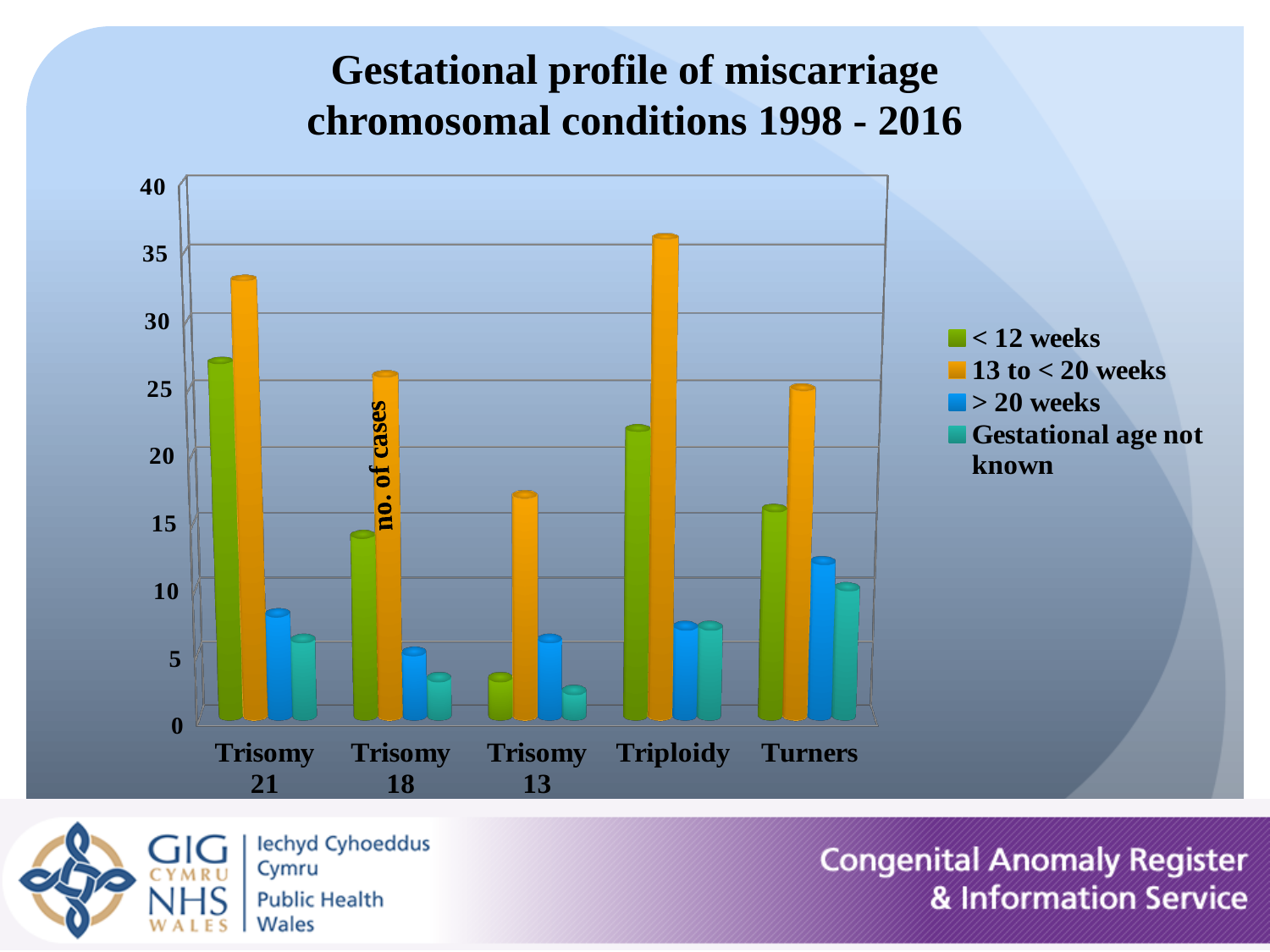
What is the title of the chart? Gestational profile of miscarriage chromosomal conditions 1998 - 2016 What kind of chart is shown on the slide? bar chart Is the value for Trisomy 21 in the 13 to < 20 weeks series greater or less than 30? greater Which is larger: the < 12 weeks value for Trisomy 21 or the < 12 weeks value for Turners? Trisomy 21 Which category has the highest value for the 13 to < 20 weeks series? Triploidy How many chromosomal condition categories are shown on the x axis? 5 Which is larger for Trisomy 18: the < 12 weeks value or the 13 to < 20 weeks value? 13 to < 20 weeks How many series does the legend list? 4 Is the value for Trisomy 13 in the < 12 weeks series greater or less than 5? less Which category has the lowest value for the < 12 weeks series? Trisomy 13 Which category has the highest value for the > 20 weeks series? Turners